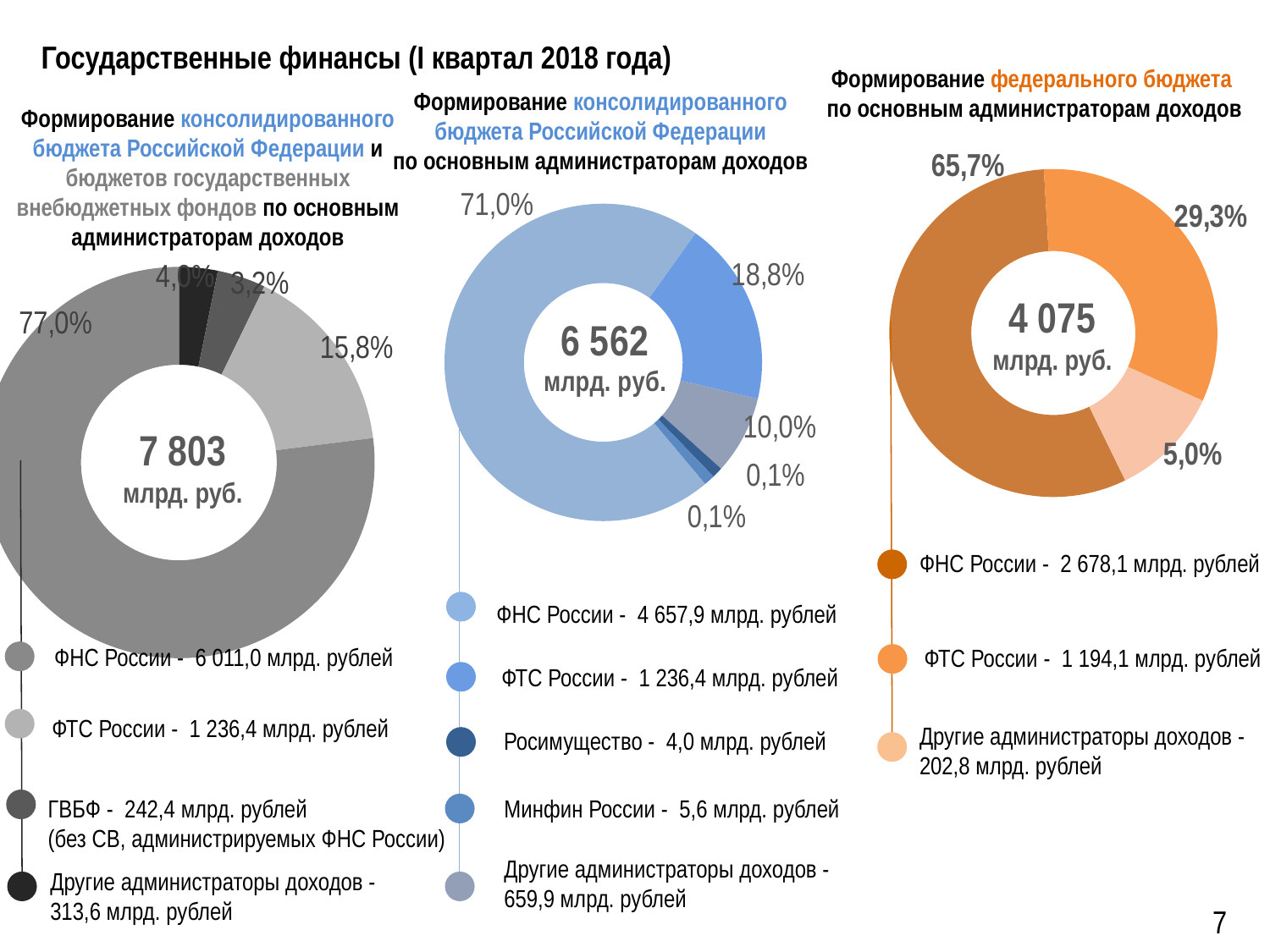
What type of chart is used on this slide to show the formation of the federal budget by revenue administrators? Pie (donut) chart How many revenue administrators are listed in the legend of the middle chart (Формирование консолидированного бюджета Российской Федерации)? 5 In the middle chart (Формирование консолидированного бюджета Российской Федерации), what is the total value shown in the centre of the donut? 6 562 млрд. руб. How many slices does the right chart (Формирование федерального бюджета) have? 3 In the left chart (consolidated budget and state extra-budgetary funds), what amount is listed for ФНС России? 6 011,0 млрд. рублей In the middle chart (Формирование консолидированного бюджета Российской Федерации), which is larger: the amount for Росимущество or the amount for Минфин России? Минфин России In the middle chart (Формирование консолидированного бюджета Российской Федерации), what share of the pie does ФНС России account for? 71,0% In the left chart (consolidated budget and state extra-budgetary funds), which revenue administrator has the smallest share? ГВБФ In the right chart (Формирование федерального бюджета), what is the difference between the amounts for ФНС России and ФТС России? 1 484,0 млрд. рублей In the right chart (Формирование федерального бюджета), what is the total value shown in the centre of the donut? 4 075 млрд. руб. In the middle chart (Формирование консолидированного бюджета Российской Федерации), which revenue administrator has the largest share? ФНС России In the right chart (Формирование федерального бюджета), what share of the pie does ФТС России account for? 29,3%